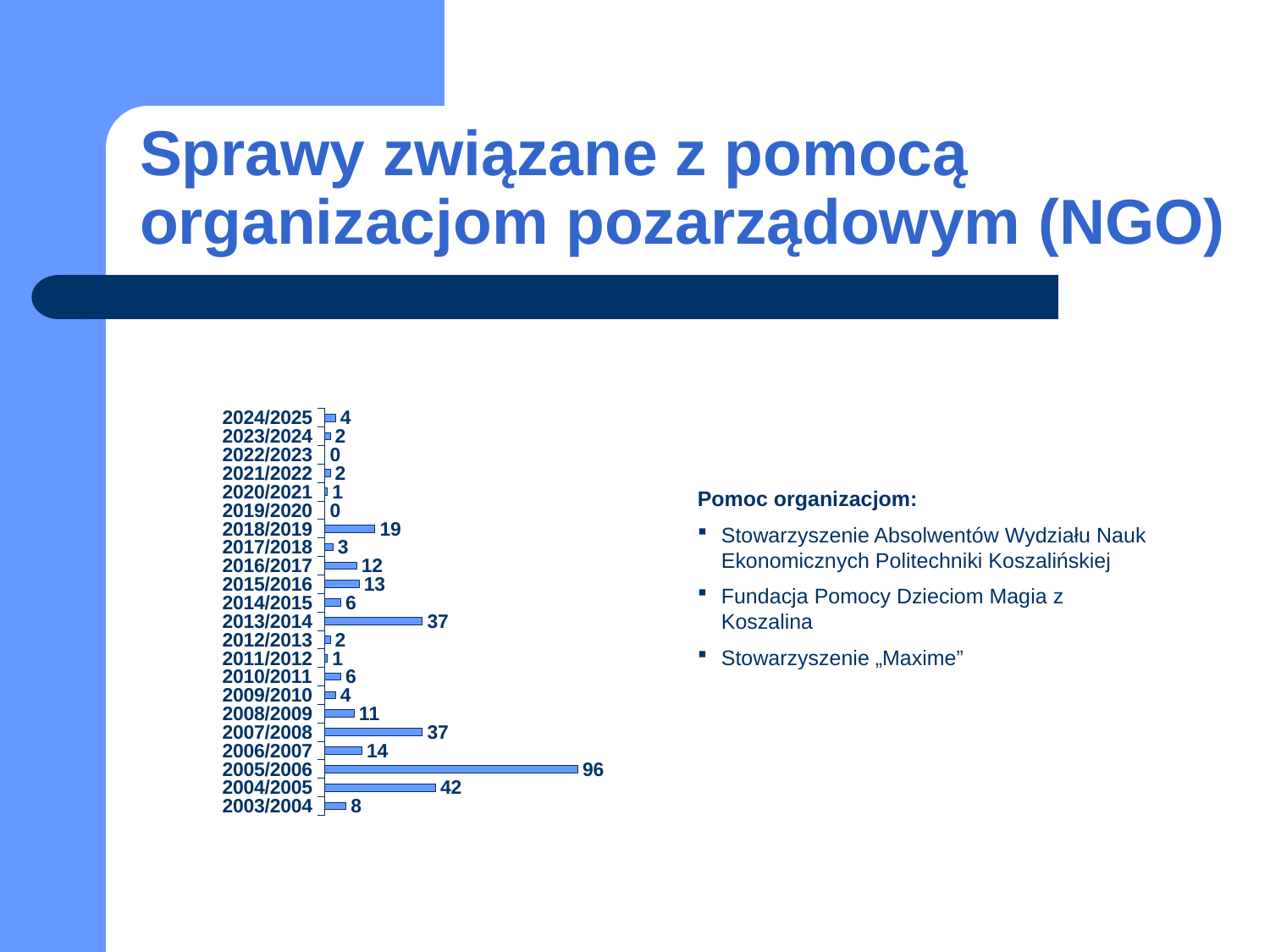
Which two categories have a value of 0? 2022/2023 and 2019/2020 What is the value for 2018/2019? 19 Which is larger, the value for 2003/2004 or the value for 2014/2015? 2003/2004 What is the value for 2024/2025? 4 Which is larger, the value for 2006/2007 or the value for 2008/2009? 2006/2007 What is the value for 2005/2006? 96 What is the difference between the values for 2016/2017 and 2015/2016? 1 What is the difference between the values for 2005/2006 and 2004/2005? 54 What is the value for 2013/2014? 37 Which category has the highest value? 2005/2006 How many categories are shown in the chart? 22 What kind of chart is shown on the slide? Bar chart